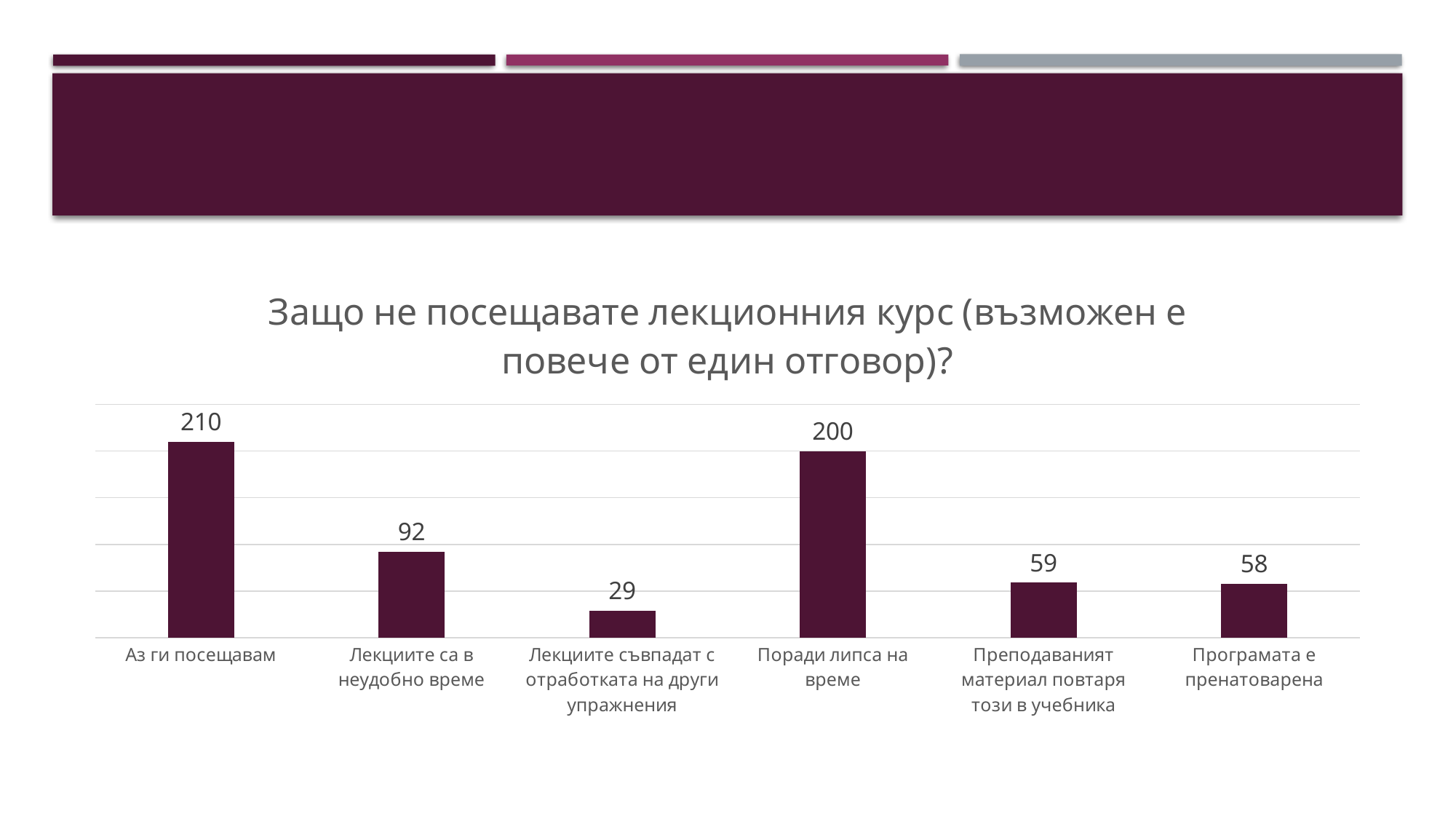
How many categories are shown in the chart? 6 What is the value for "Аз ги посещавам"? 210 What is the title of the chart? Защо не посещавате лекционния курс (възможен е повече от един отговор)? What is the value for "Програмата е пренатоварена"? 58 Which category has the highest value? Аз ги посещавам What is the value for "Поради липса на време"? 200 Which category has the lowest value? Лекциите съвпадат с отработката на други упражнения What kind of chart is shown on the slide? Bar chart What is the value for "Лекциите съвпадат с отработката на други упражнения"? 29 What is the difference between the values for "Аз ги посещавам" and "Поради липса на време"? 10 Which is larger: the value for "Лекциите са в неудобно време" or the value for "Преподаваният материал повтаря този в учебника"? Лекциите са в неудобно време What is the difference between the values for "Лекциите са в неудобно време" and "Лекциите съвпадат с отработката на други упражнения"? 63